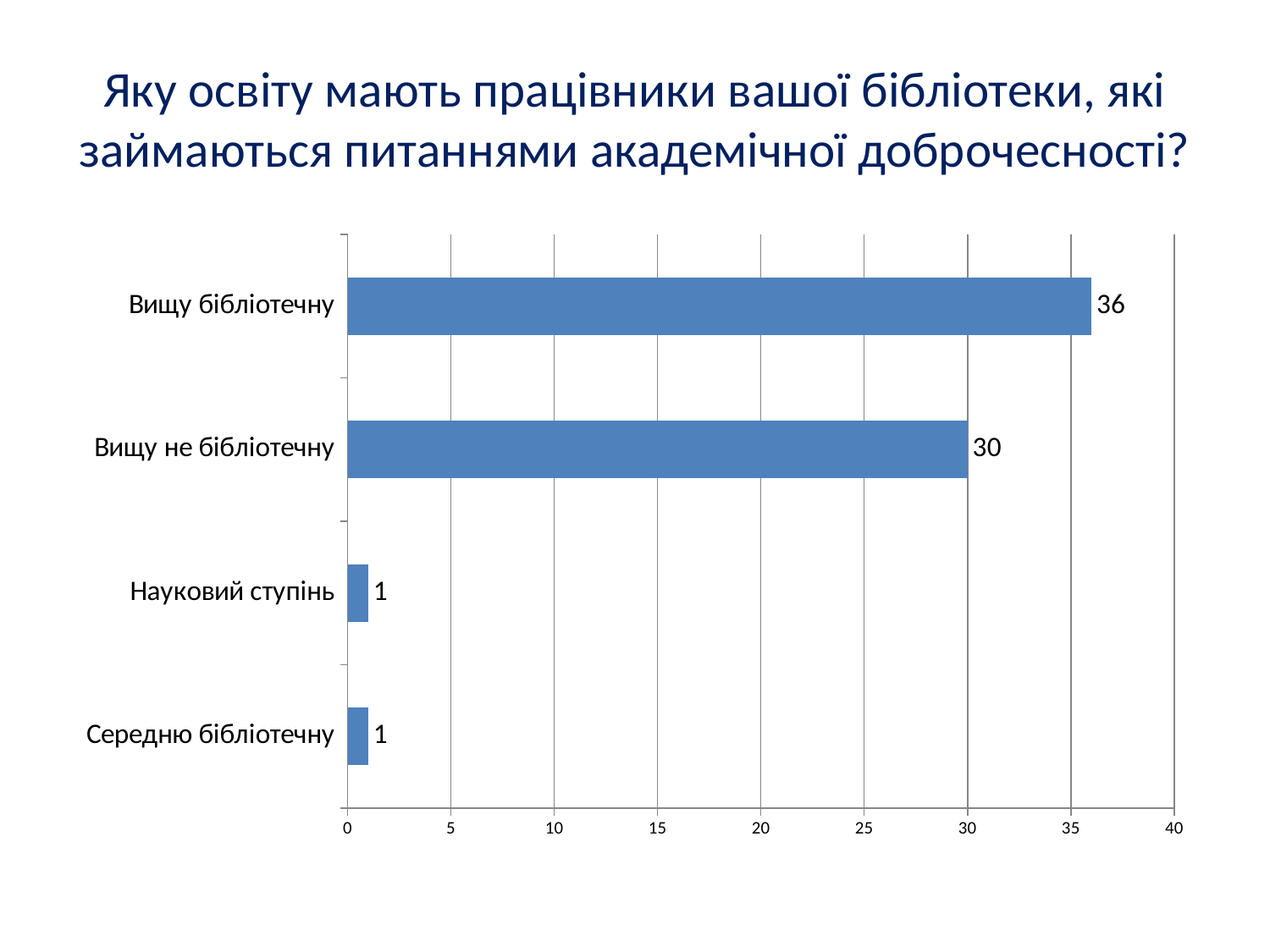
How many categories are shown in the chart? 4 What is the total of the values for Вищу бібліотечну and Вищу не бібліотечну? 66 What is the value for Науковий ступінь? 1 Which category has the highest value? Вищу бібліотечну What is the difference between the values for Вищу бібліотечну and Вищу не бібліотечну? 6 What is the maximum value shown on the horizontal axis? 40 What kind of chart is shown on the slide? bar chart Which is larger, the value for Вищу не бібліотечну or the value for Науковий ступінь? Вищу не бібліотечну Is the value for Вищу бібліотечну greater or less than 35? greater What is the value for Середню бібліотечну? 1 What is the value for Вищу бібліотечну? 36 What is the value for Вищу не бібліотечну? 30